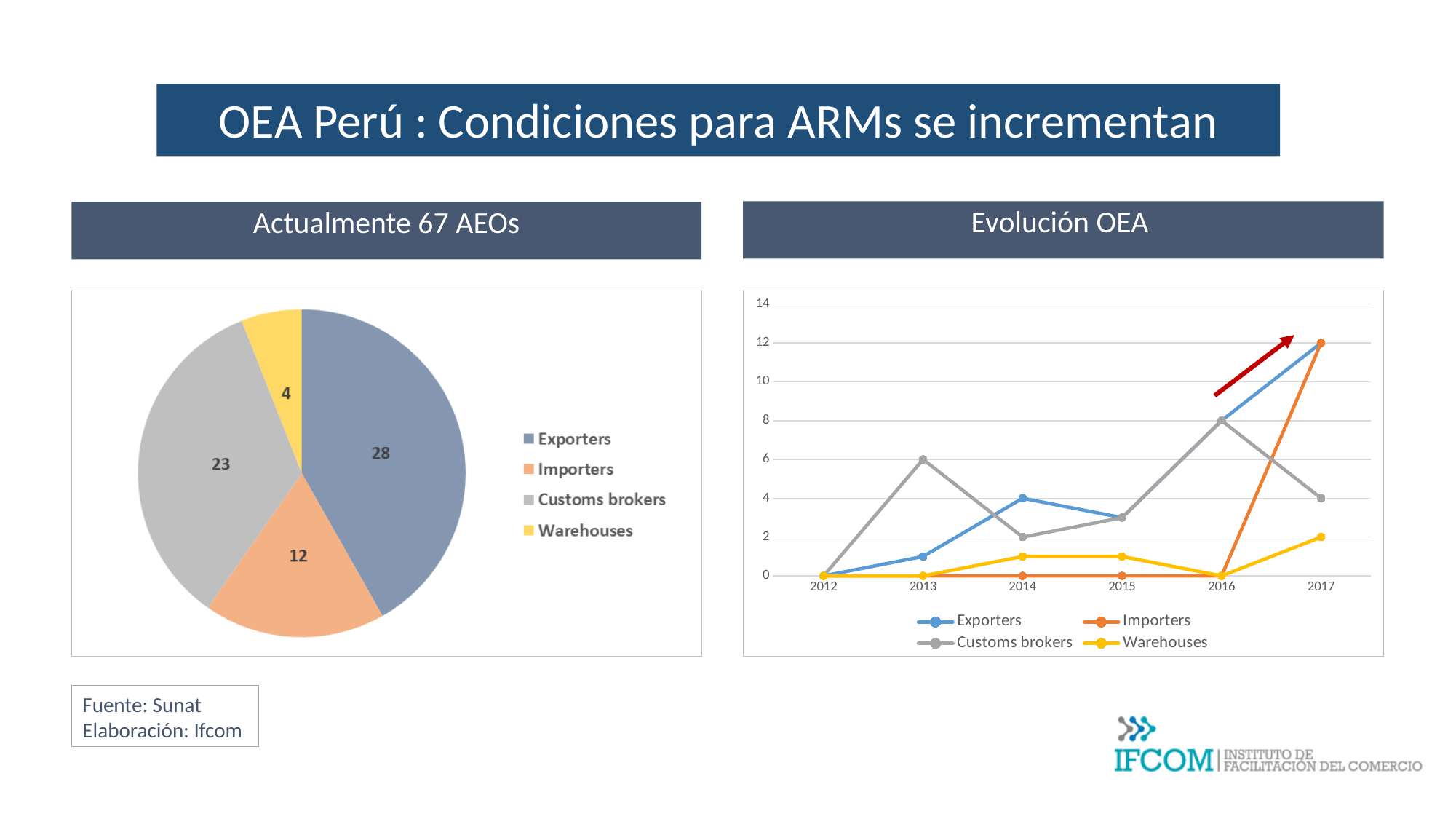
In the 'Actualmente 67 AEOs' pie chart, what is the value for Warehouses? 4 In the 'Actualmente 67 AEOs' pie chart, what is the difference between Customs brokers and Importers? 11 In the 'Actualmente 67 AEOs' pie chart, which category has the smallest slice? Warehouses In the 'Evolución OEA' chart, is the value for Customs brokers in 2013 greater or less than 4? greater What kind of chart is the 'Evolución OEA' chart? line chart In the 'Actualmente 67 AEOs' pie chart, what is the value for Exporters? 28 What kind of chart is the 'Actualmente 67 AEOs' chart? pie chart In the 'Evolución OEA' chart, does the Importers line rise or fall from 2016 to 2017? rise How many categories does the 'Actualmente 67 AEOs' pie chart show? 4 In the 'Evolución OEA' chart, what is the value for Customs brokers in 2016? 8 In the 'Actualmente 67 AEOs' pie chart, which category has the largest slice? Exporters How many series does the legend of the 'Evolución OEA' chart list? 4